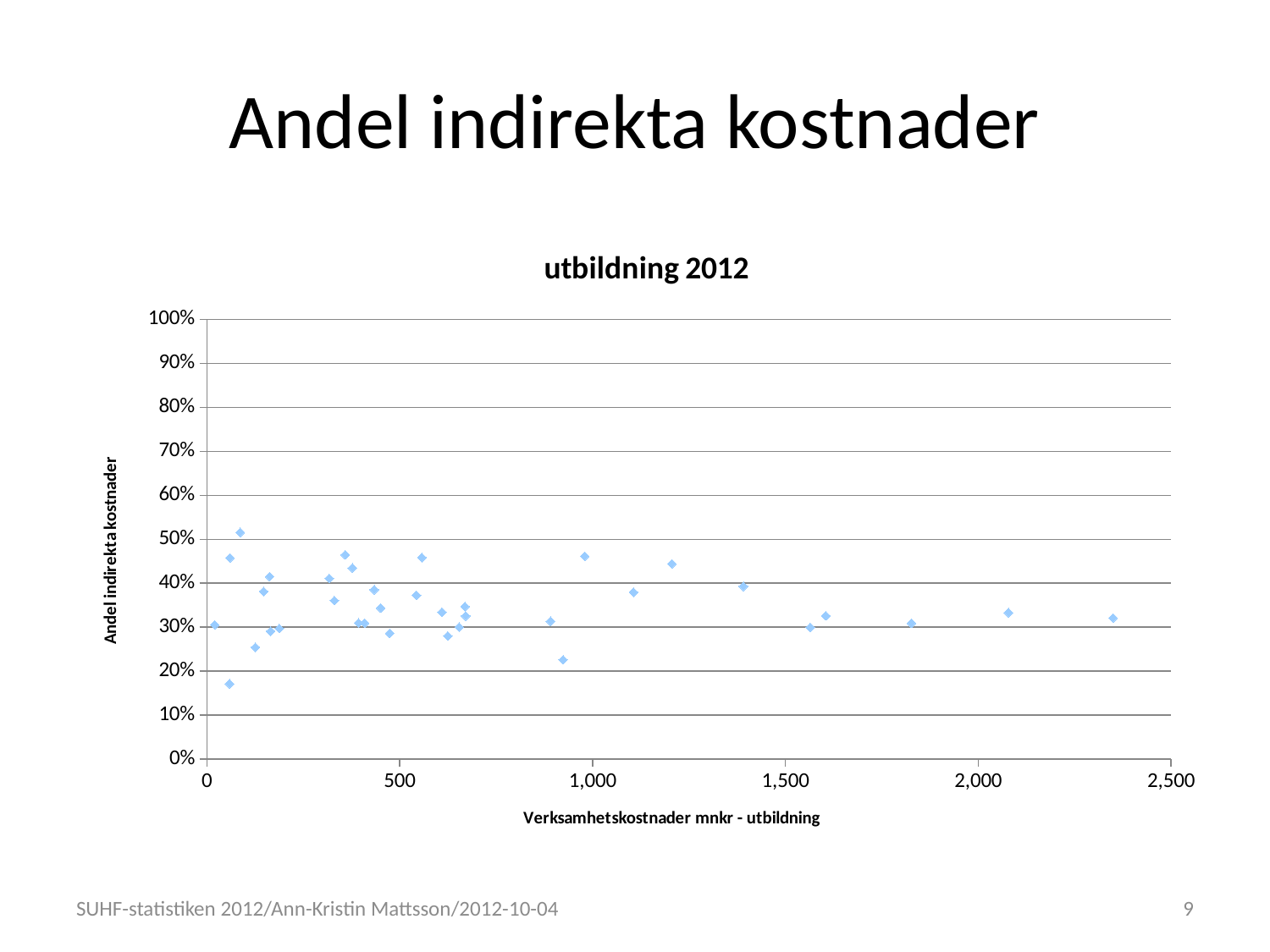
Is the value for the point near 1,000 on the x axis greater or less than 40%? greater Is the value for the point near 1,200 on the x axis greater or less than 40%? greater Is the value for the lowest point on the chart greater or less than 20%? less What kind of chart is shown on the slide? scatter chart Which is larger: the value for the highest point on the chart or the value for the rightmost point? the highest point What is the label of the horizontal axis of the chart? Verksamhetskostnader mnkr - utbildning What is the title of the chart? utbildning 2012